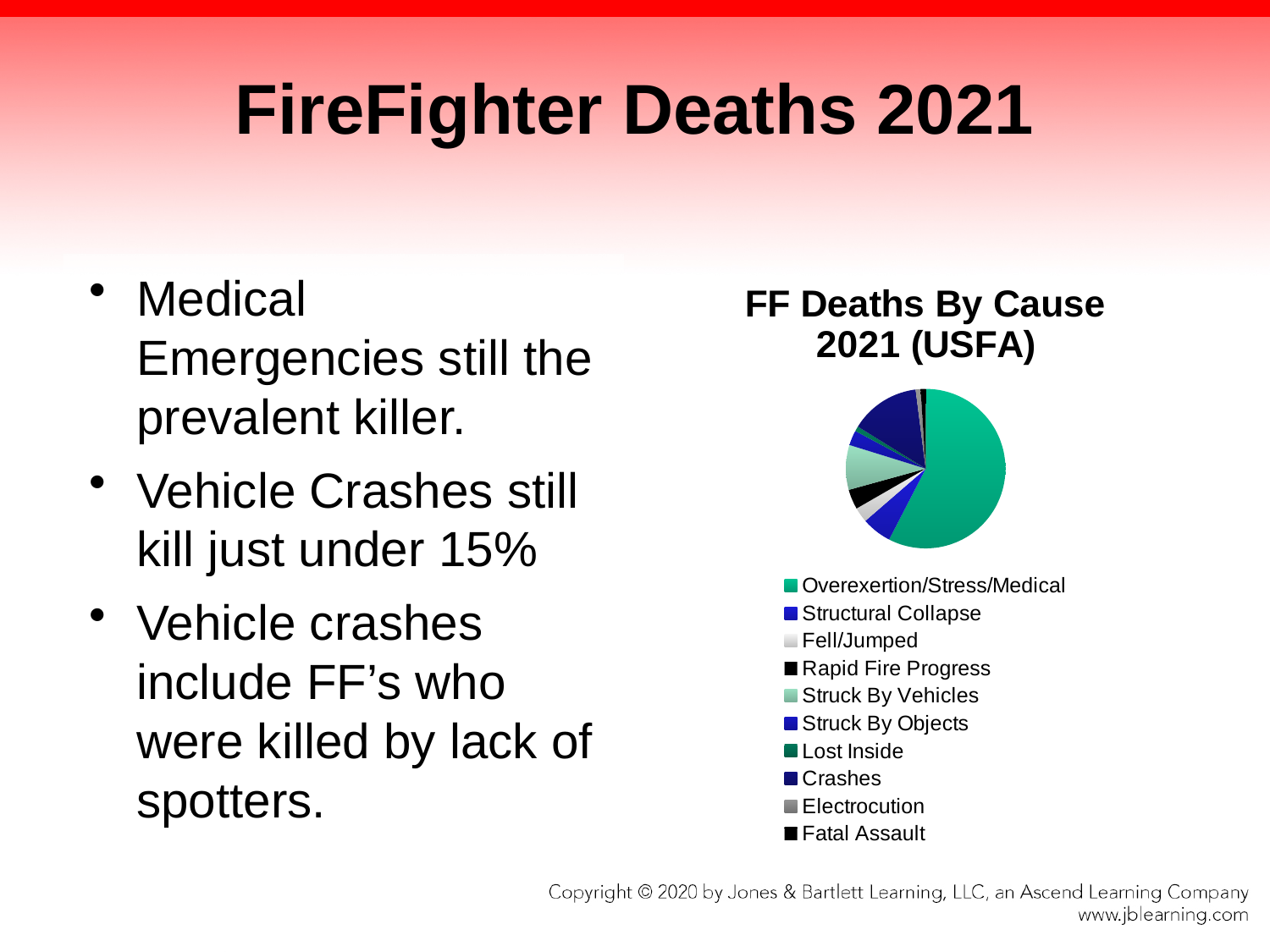
Which cause accounts for the largest slice of the pie? Overexertion/Stress/Medical Which legend entry is listed first in the chart's legend? Overexertion/Stress/Medical Which is larger, the slice for Struck By Vehicles or the slice for Electrocution? Struck By Vehicles Which is larger, the slice for Overexertion/Stress/Medical or the slice for Crashes? Overexertion/Stress/Medical Which is larger, the slice for Crashes or the slice for Lost Inside? Crashes How many categories does the chart's legend list? 10 What is the title of the chart? FF Deaths By Cause 2021 (USFA) Does the Overexertion/Stress/Medical slice take up more or less than half of the pie? more What kind of chart is shown on the slide? pie chart